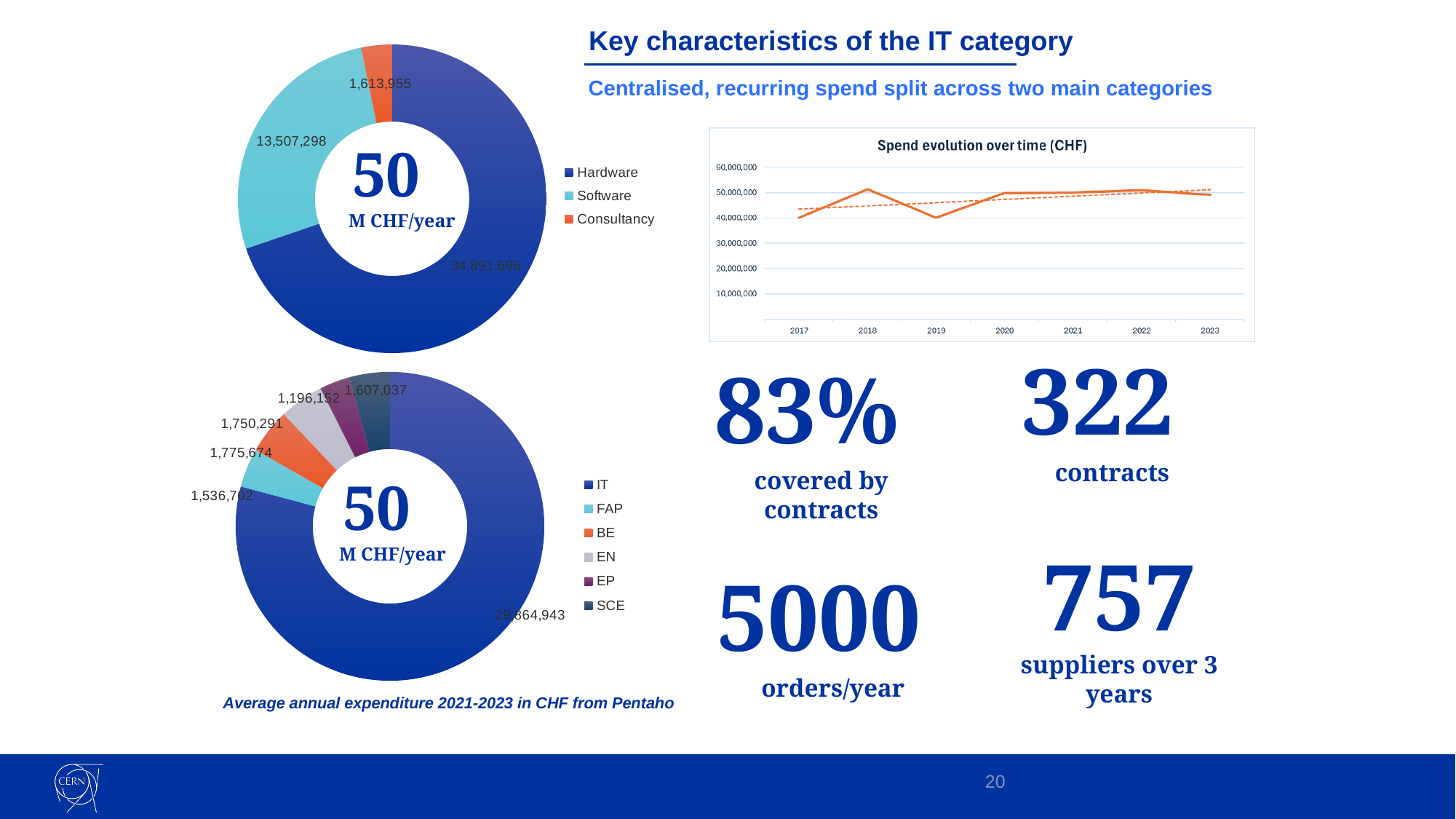
In the top-left doughnut chart, which category has the smallest value? Consultancy How many categories does the legend of the bottom-left doughnut chart list? 6 In the 'Spend evolution over time (CHF)' chart, how many years are shown on the x axis? 7 In the top-left doughnut chart, what is the value for Hardware? 34,891,696 What kind of chart is 'Spend evolution over time (CHF)'? Line chart In the top-left doughnut chart, what is the value for Consultancy? 1,613,955 In the 'Spend evolution over time (CHF)' chart, is the value for 2019 greater or less than 50,000,000? less In the bottom-left doughnut chart, what is the value for IT? 29,864,943 In the top-left doughnut chart, which category has the largest value? Hardware In the bottom-left doughnut chart, which category has the largest value? IT In the top-left doughnut chart, what is the difference between the Hardware and Software values? 21,384,398 In the top-left doughnut chart, what is the value for Software? 13,507,298